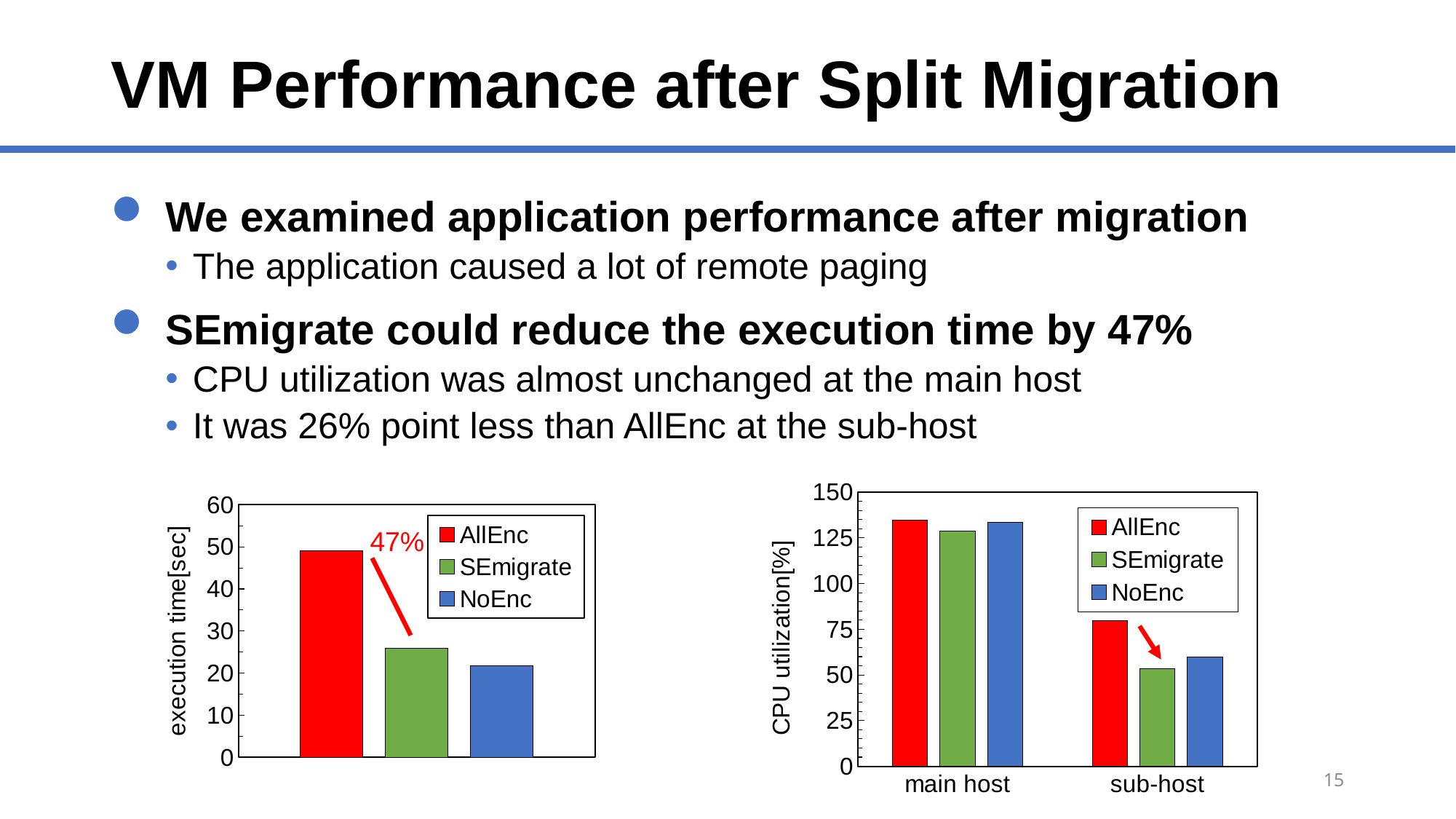
In the left chart (execution time[sec]), is the value for AllEnc greater or less than 40? greater In the left chart (execution time[sec]), how many series does the legend list? 3 What kind of chart is the left chart with the y axis labelled execution time[sec]? bar chart In the left chart (execution time[sec]), which series has the lowest execution time? NoEnc In the right chart (CPU utilization[%]), is the value for SEmigrate at sub-host greater or less than 75? less In the right chart (CPU utilization[%]), is the value for AllEnc at sub-host greater or less than 75? greater What is the y axis label of the right chart? CPU utilization[%] In the right chart (CPU utilization[%]), which is larger at sub-host: AllEnc or SEmigrate? AllEnc In the left chart (execution time[sec]), which series has the highest execution time? AllEnc In the right chart (CPU utilization[%]), how many categories are shown on the x axis? 2